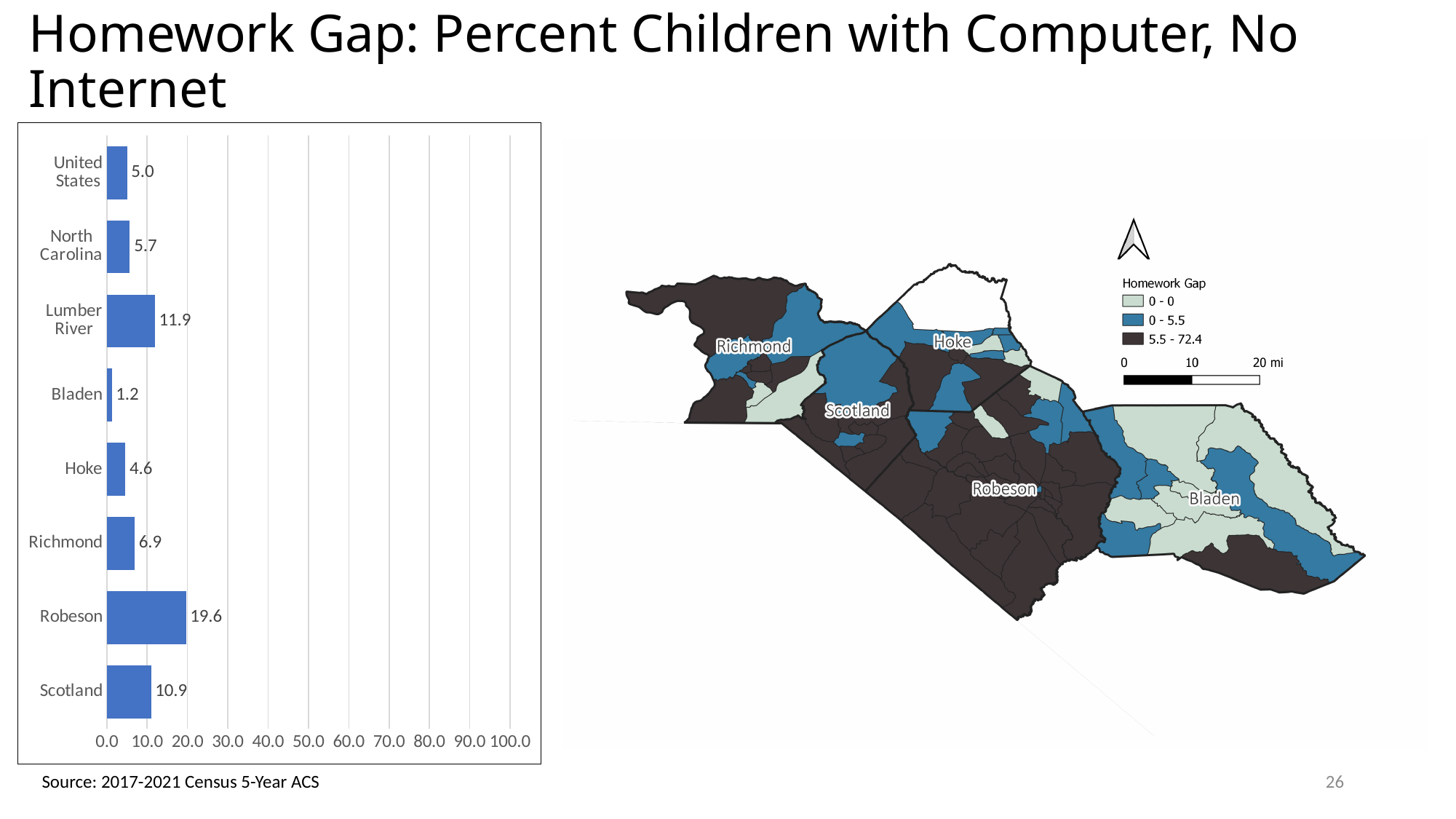
Which is larger in the bar chart, the value for Richmond or the value for Hoke? Richmond How many categories are shown in the bar chart? 8 What is the value for Robeson in the bar chart? 19.6 What is the value for North Carolina in the bar chart? 5.7 What kind of chart is shown on the left of the slide? Bar chart What is the difference between the values for Lumber River and the United States in the bar chart? 6.9 Which category has the highest value in the bar chart? Robeson What is the difference between the values for Robeson and Scotland in the bar chart? 8.7 What is the highest value shown on the x axis of the bar chart? 100.0 Which category has the lowest value in the bar chart? Bladen Is the value for Scotland in the bar chart greater or less than 20.0? less What is the value for Lumber River in the bar chart? 11.9